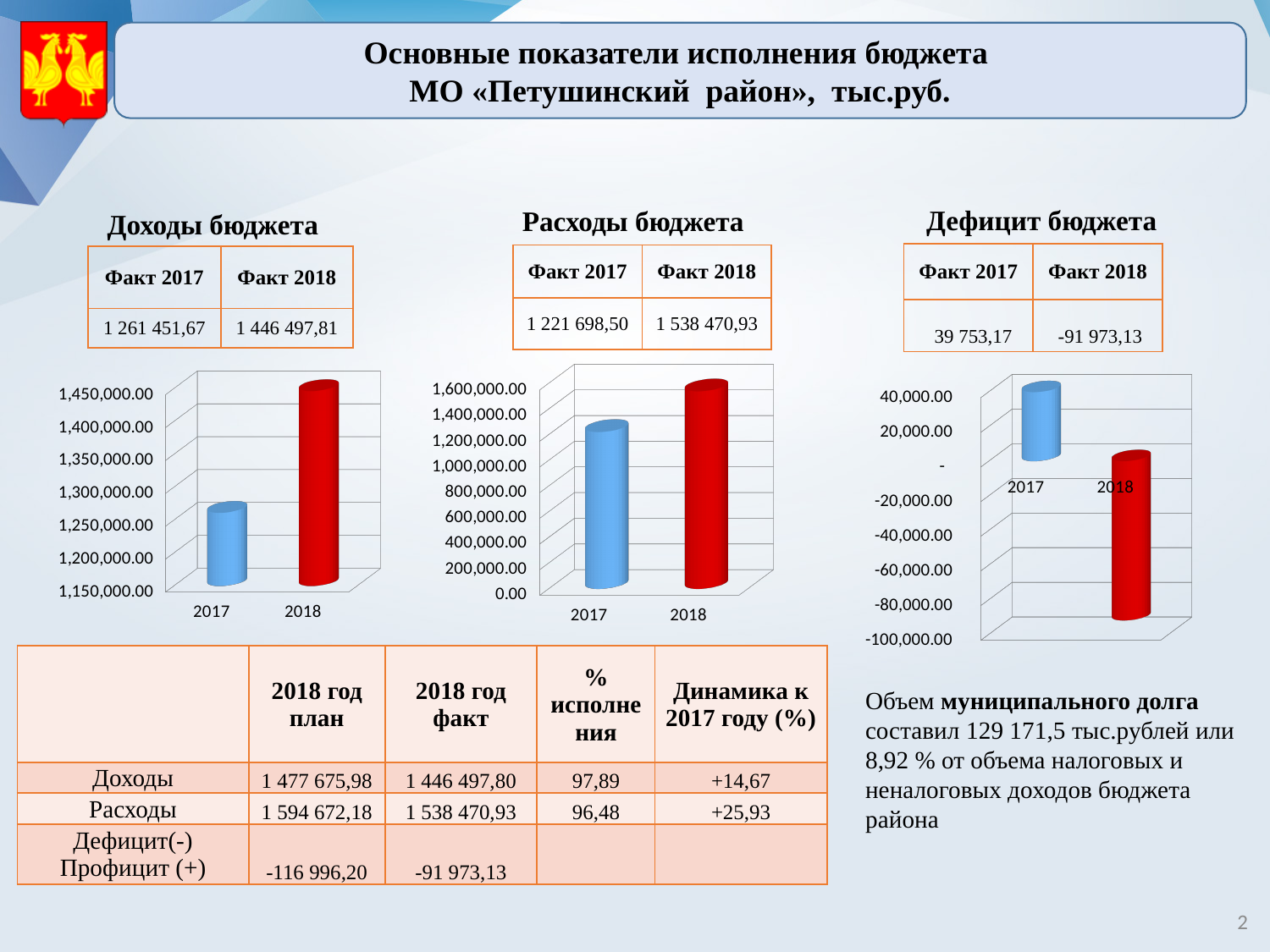
On the 'Расходы бюджета' chart, what is the value for 2018? 1 538 470,93 On the 'Расходы бюджета' chart, is the value for 2017 greater or less than 1,000,000.00? greater On the 'Расходы бюджета' chart, what is the difference between the 2018 and 2017 values? 316 772,43 On the 'Доходы бюджета' chart, what is the value for 2017? 1 261 451,67 What kind of chart is the 'Доходы бюджета' chart? bar chart On the 'Дефицит бюджета' chart, do the values rise or fall from 2017 to 2018? fall How many categories are plotted on the 'Доходы бюджета' chart? 2 On the 'Доходы бюджета' chart, is the value for 2018 greater or less than 1,400,000.00? greater On the 'Доходы бюджета' chart, what is the difference between the 2018 and 2017 values? 185 046,14 On the 'Доходы бюджета' chart, which year has the higher value? 2018 On the 'Дефицит бюджета' chart, what colour is the bar for 2018? red On the 'Дефицит бюджета' chart, what is the value for 2018? -91 973,13